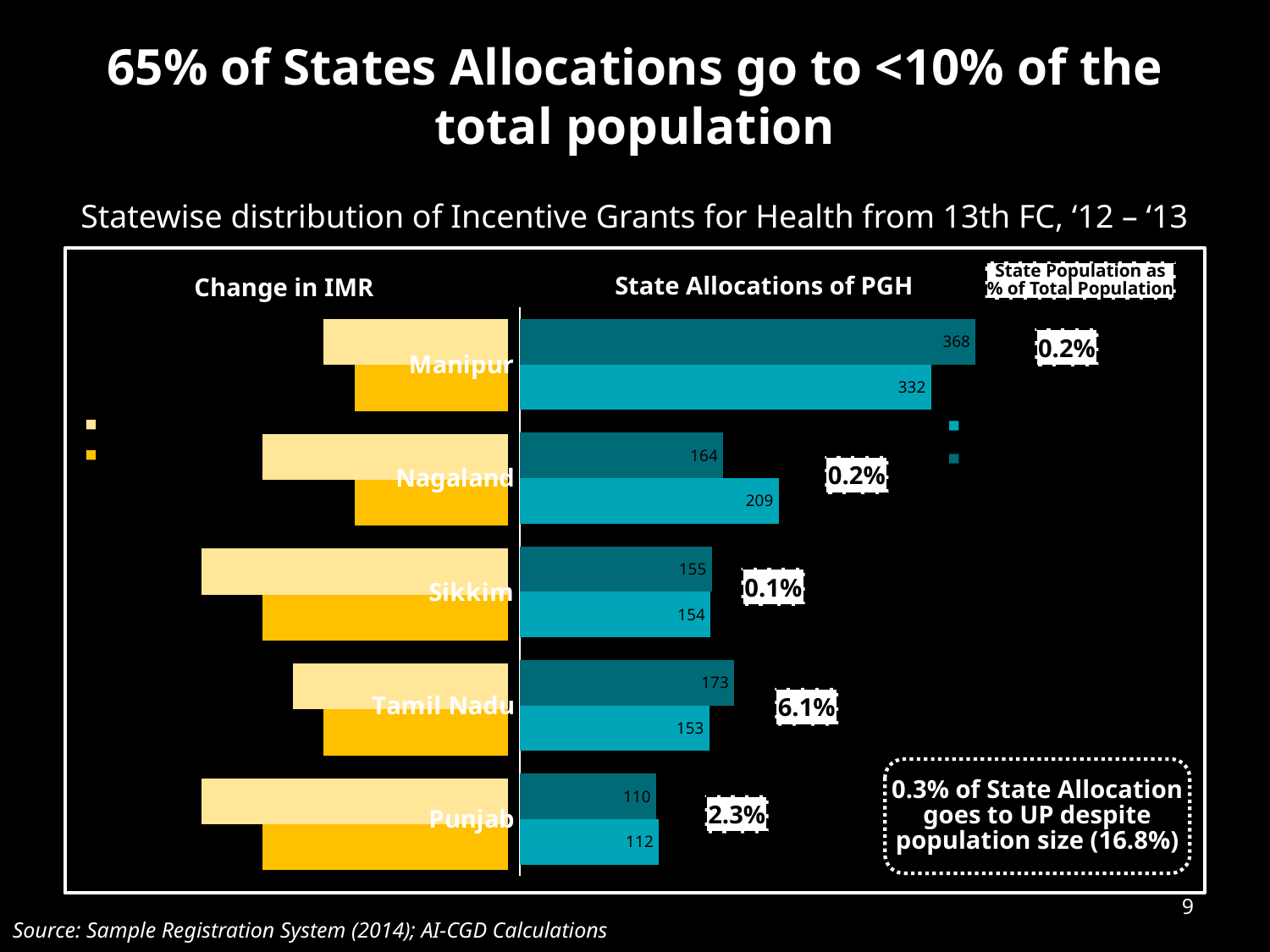
In the State Allocations of PGH chart, what is the value of the upper (darker teal) bar for Tamil Nadu? 173 In the State Allocations of PGH chart, what is the value of the upper (darker teal) bar for Manipur? 368 In the State Allocations of PGH chart, which is larger for Tamil Nadu: the upper (darker teal) bar or the lower (lighter teal) bar? the upper (darker teal) bar In the State Allocations of PGH chart, which state has the highest value among the upper (darker teal) bars? Manipur In the State Allocations of PGH chart, what is the value of the lower (lighter teal) bar for Punjab? 112 What State Population as % of Total Population is shown next to Tamil Nadu? 6.1% How many states are shown in the chart? 5 In the State Allocations of PGH chart, what is the value of the lower (lighter teal) bar for Nagaland? 209 In the State Allocations of PGH chart, which state has the lowest value among the lower (lighter teal) bars? Punjab What kind of chart is used to show the State Allocations of PGH? bar chart In the State Allocations of PGH chart, what is the difference between the two bars for Manipur (368 and 332)? 36 In the State Allocations of PGH chart, what is the difference between the two bars for Nagaland (209 and 164)? 45